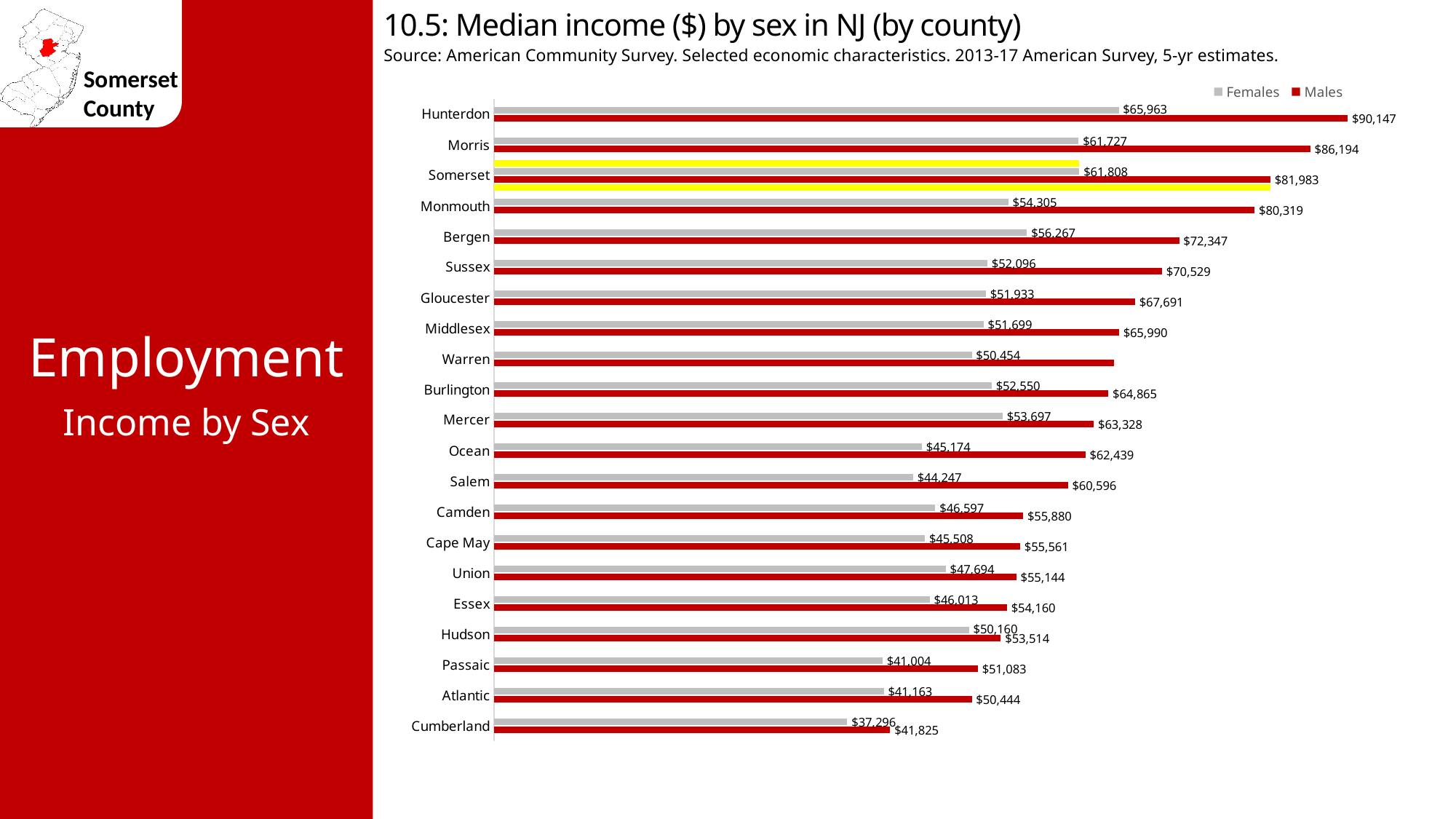
What is the median income for males in Somerset County? $81,983 Which county has the lowest median income for females? Cumberland Which colour represents Females in the chart? Gray Which county has the highest median income for males? Hunterdon What is the difference between male and female median income in Somerset County? $20,175 What is the median income for males in Cumberland County? $41,825 What is the difference between male median income in Hunterdon and in Morris? $3,953 Which is larger: the female median income in Bergen or in Monmouth? Bergen How many counties are shown in the chart? 21 What kind of chart is shown on the slide? Bar chart How many series does the legend list? 2 What is the median income for females in Hunterdon County? $65,963